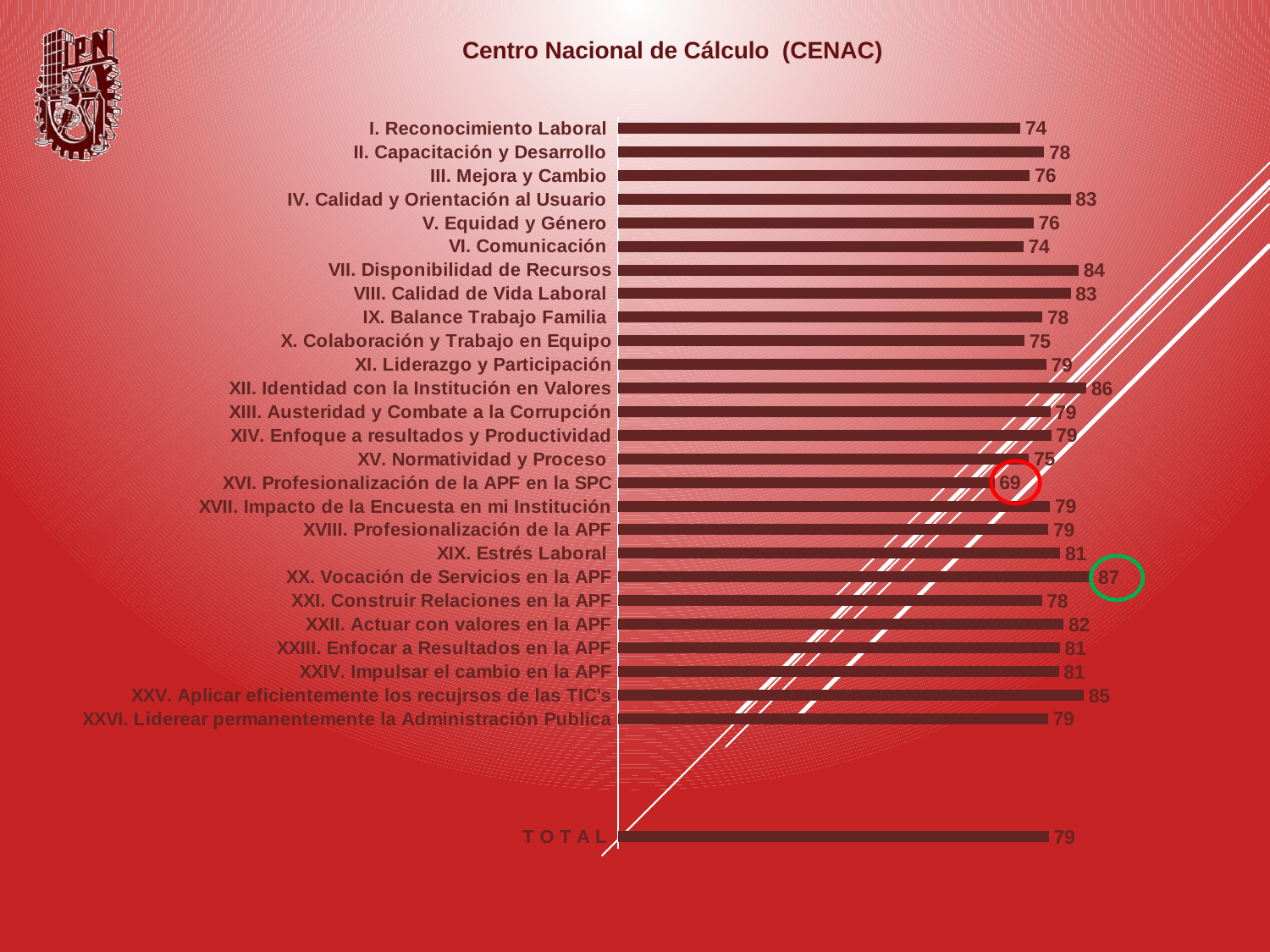
What is the value for I. Reconocimiento Laboral? 74 What is the value shown for TOTAL? 79 What is the value for XII. Identidad con la Institución en Valores? 86 What type of chart is shown on the slide? Bar chart What is the difference between the values for XXII. Actuar con valores en la APF and XXI. Construir Relaciones en la APF? 4 Which is larger, the value for VII. Disponibilidad de Recursos or the value for IV. Calidad y Orientación al Usuario? VII. Disponibilidad de Recursos What is the value for XXV. Aplicar eficientemente los recujrsos de las TIC's? 85 How many bars are plotted on the chart, including TOTAL? 27 What is the title of the chart? Centro Nacional de Cálculo (CENAC) What is the difference between the values for XX. Vocación de Servicios en la APF and XVI. Profesionalización de la APF en la SPC? 18 Which category has the lowest value? XVI. Profesionalización de la APF en la SPC Which category has the highest value? XX. Vocación de Servicios en la APF